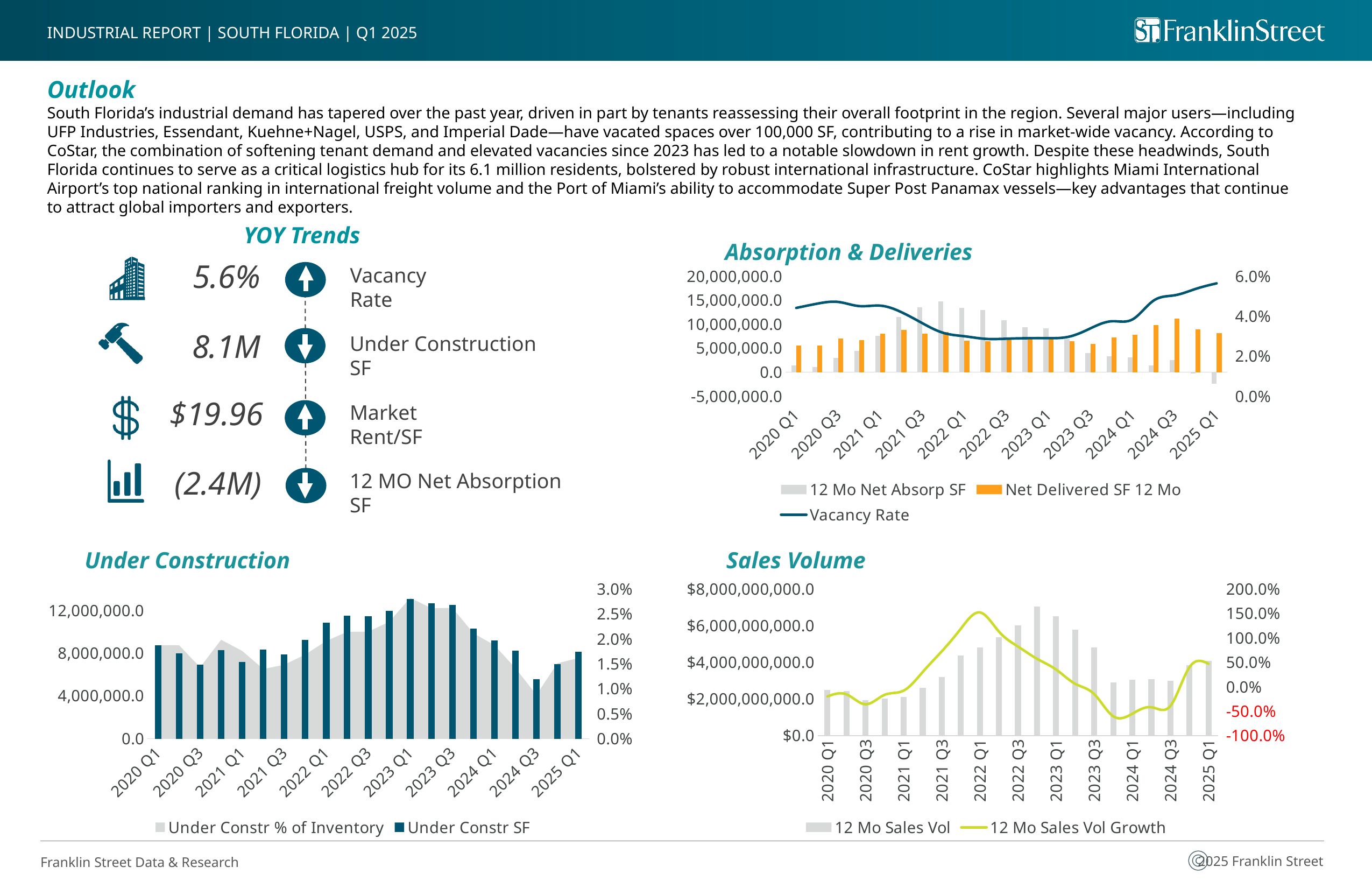
In the Absorption & Deliveries chart, is the Vacancy Rate for 2023 Q1 greater or less than 4.0%? less In the Under Construction chart, which quarter has the highest Under Constr SF bar? 2023 Q1 In the Absorption & Deliveries chart, does the Vacancy Rate line rise or fall from 2023 Q1 to 2025 Q1? rise In the Sales Volume chart, which quarter has the highest 12 Mo Sales Vol bar? 2022 Q4 In the Sales Volume chart, is the 12 Mo Sales Vol Growth value for 2024 Q1 greater or less than 0.0%? less In the Absorption & Deliveries chart, is the Vacancy Rate for 2025 Q1 greater or less than 4.0%? greater In the Under Construction chart, how many series does the legend list? 2 In the Absorption & Deliveries chart, how many series does the legend list? 3 In the Under Construction chart, which quarter has the lowest Under Constr SF bar? 2024 Q3